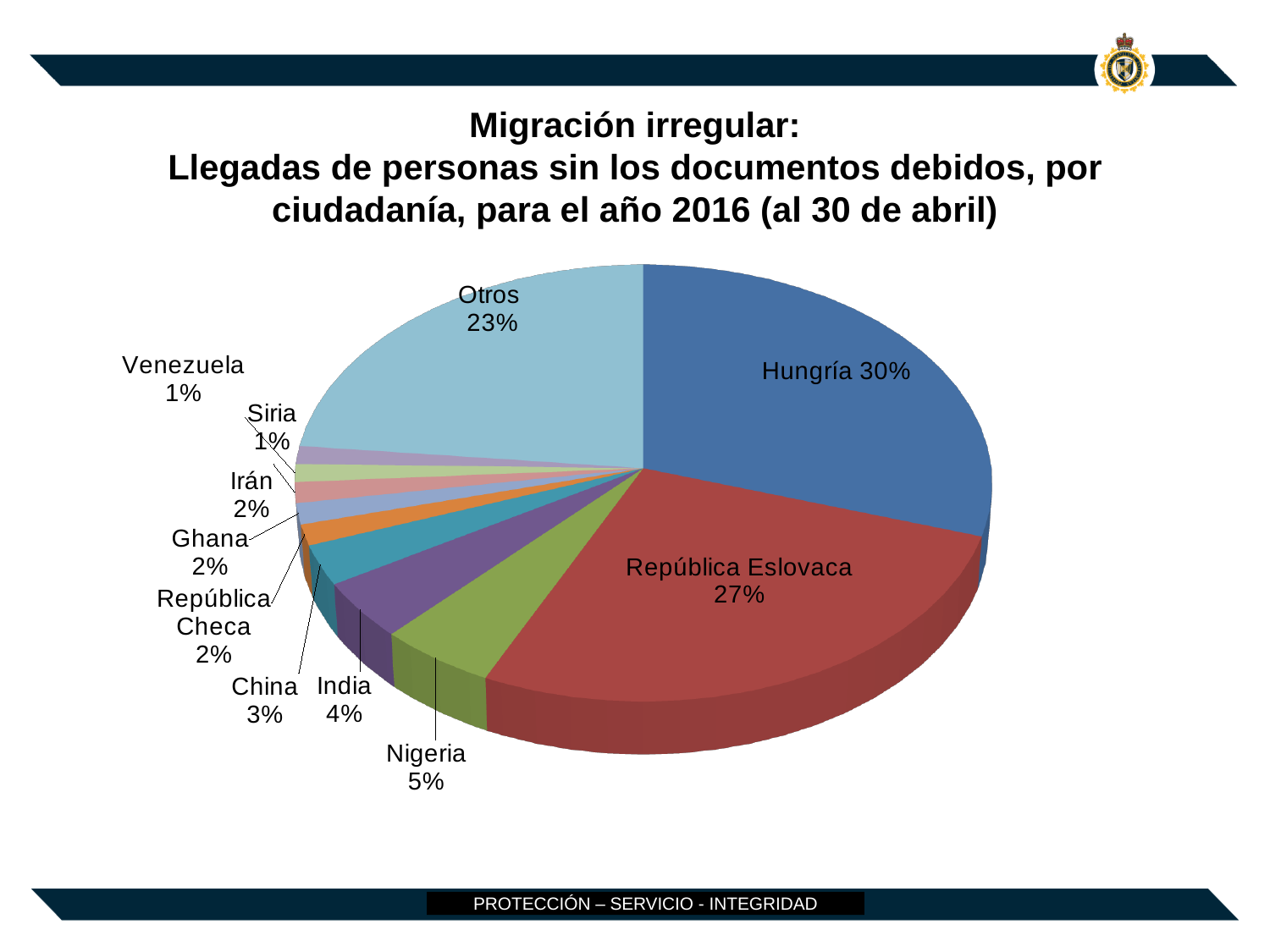
What share of the pie does Hungría account for? 30% What percentage is shown for Otros? 23% Which is larger, the slice for India or the slice for China? India What is the combined percentage of Hungría and República Eslovaca? 57% What percentage is shown for Venezuela? 1% What is the difference in percentage points between Hungría and República Eslovaca? 3 What percentage is shown for Nigeria? 5% What percentage is shown for República Eslovaca? 27% What kind of chart is shown on the slide? Pie chart Which named citizenship has the largest slice of the pie? Hungría How many slices does the pie chart have? 11 What is the difference in percentage points between Nigeria and India? 1